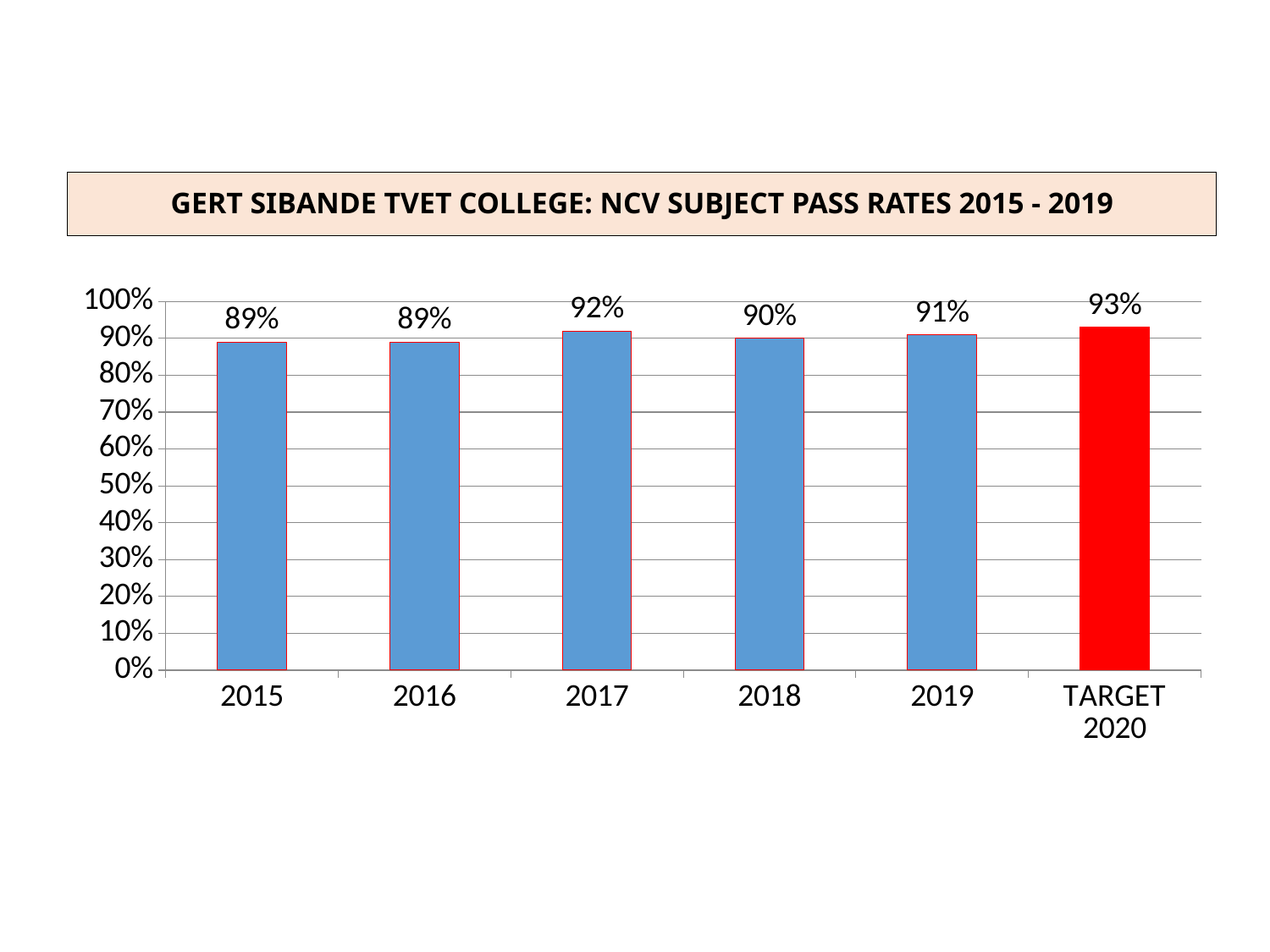
Which year between 2015 and 2019 had the highest pass rate? 2017 What kind of chart is shown on the slide? Bar chart What is the NCV subject pass rate for 2017? 92% Which bar is coloured red rather than blue? TARGET 2020 Which is larger, the pass rate for 2018 or for 2019? 2019 What is the title of the chart? GERT SIBANDE TVET COLLEGE: NCV SUBJECT PASS RATES 2015 - 2019 Which category has the highest value on the chart? TARGET 2020 What is the value shown for TARGET 2020? 93% What is the difference between the 2017 and 2015 pass rates? 3% What is the difference between the TARGET 2020 value and the 2019 pass rate? 2% How many bars are shown on the chart? 6 What is the NCV subject pass rate for 2019? 91%